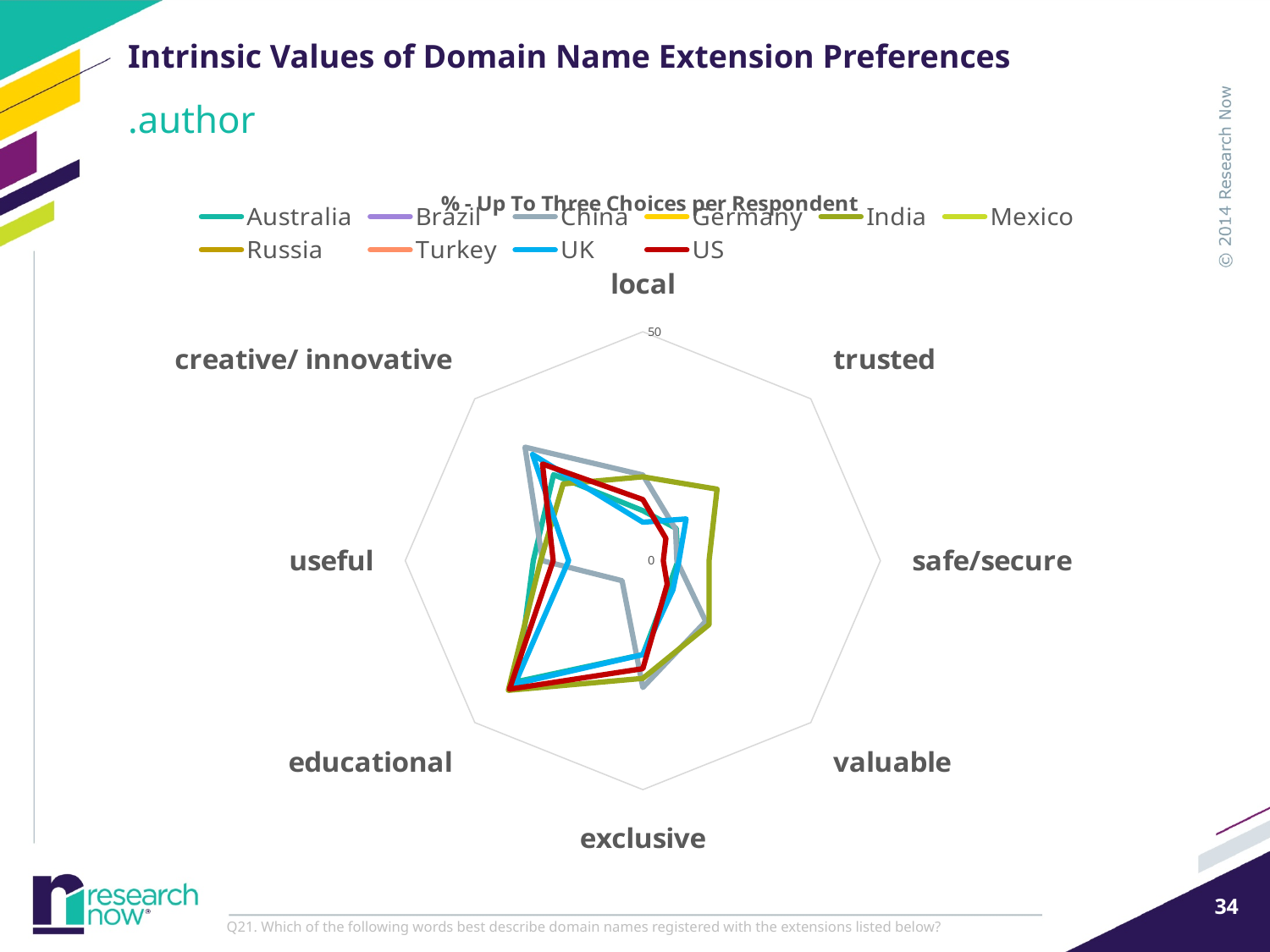
Is the value for US on the local axis greater or less than 50? less Is the value for India on the safe/secure axis greater or less than 50? less Is the value for India on the trusted axis greater or less than 50? less Which domain extension is the slide about? .author How many series does the legend list? 10 What is the title of the chart? % - Up To Three Choices per Respondent How many categories (axes) does the radar chart have? 8 What kind of chart is shown on the slide? radar chart